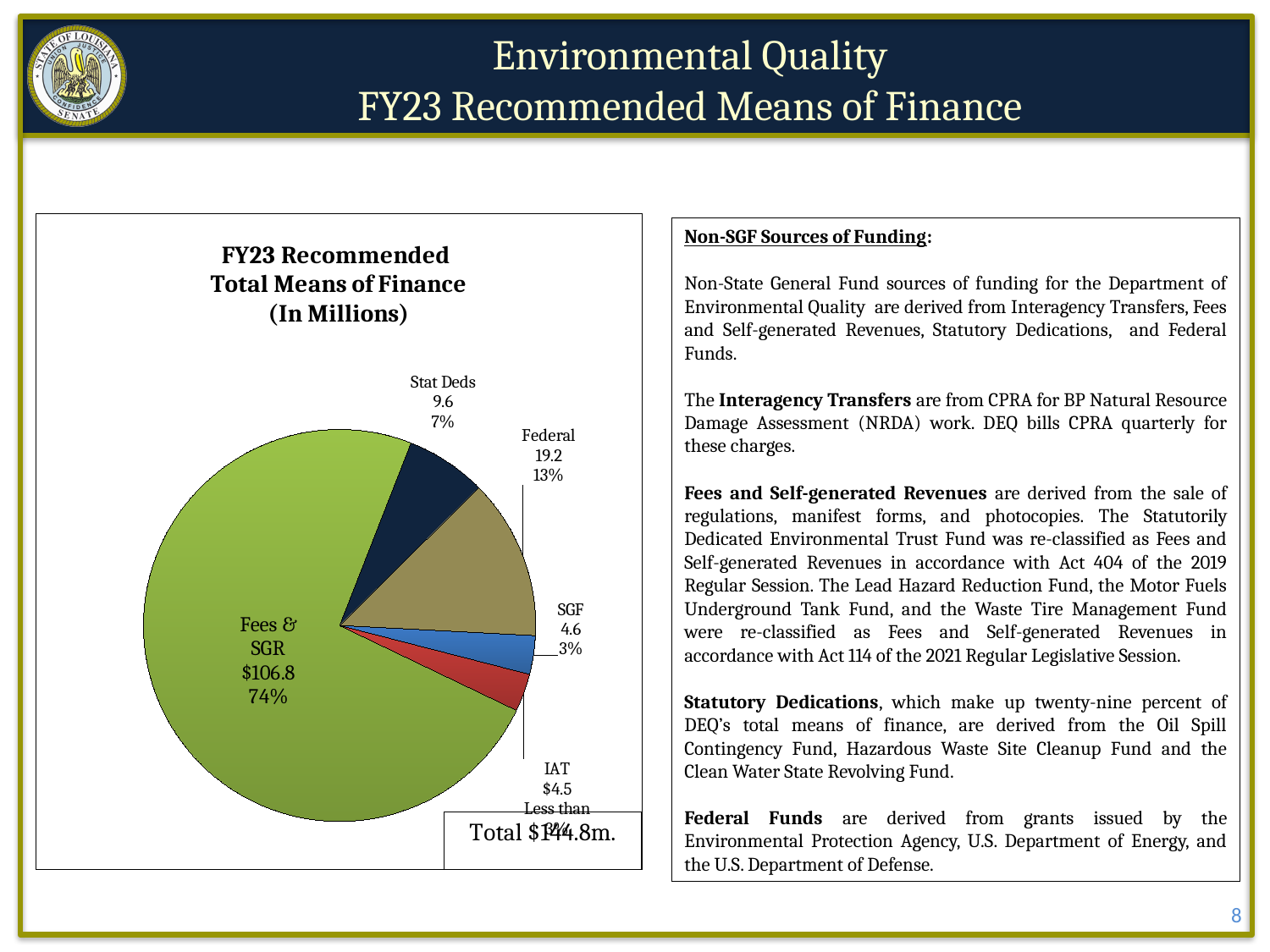
What is the value shown for Stat Deds? 9.6 What percentage share does Fees & SGR have in the pie chart? 74% How many slices does the pie chart have? 5 What percentage share does Federal have in the pie chart? 13% What is the difference between the Federal value and the Stat Deds value? 9.6 Which category has the largest slice of the pie? Fees & SGR What is the value shown for Federal? 19.2 Which is larger, Federal or Stat Deds? Federal What is the title of the chart? FY23 Recommended Total Means of Finance (In Millions) What type of chart is shown on the slide? pie chart What is the value shown for Fees & SGR? $106.8 What percentage share does SGF have in the pie chart? 3%